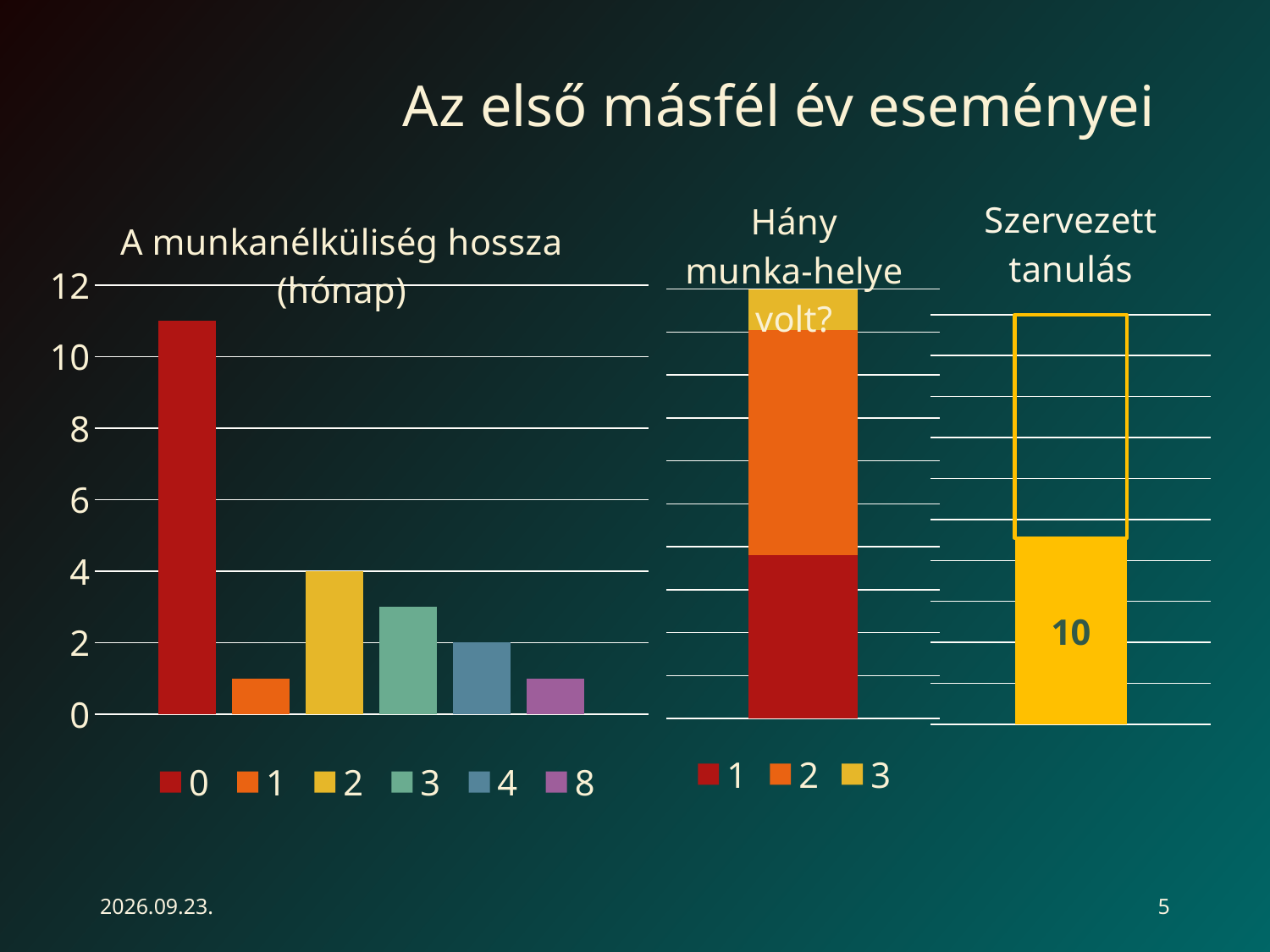
In the chart titled "A munkanélküliség hossza (hónap)", is the value for category 3 greater or less than 4? less In the chart titled "A munkanélküliség hossza (hónap)", is the value for category 0 greater or less than 10? greater What is the highest value shown on the vertical axis of the chart titled "A munkanélküliség hossza (hónap)"? 12 In the chart titled "A munkanélküliség hossza (hónap)", which is larger, the value for category 2 or the value for category 4? 2 In the chart titled "Szervezett tanulás", what value is printed on the bar? 10 In the chart titled "A munkanélküliség hossza (hónap)", what is the value for category 2? 4 In the chart titled "Hány munka-helye volt?", how many series does the legend list? 3 In the chart titled "Hány munka-helye volt?", which series occupies the largest segment of the stacked bar? 2 In the chart titled "A munkanélküliség hossza (hónap)", how many entries does the legend list? 6 In the chart titled "A munkanélküliség hossza (hónap)", which category has the highest bar? 0 In the chart titled "A munkanélküliség hossza (hónap)", what is the value for category 4? 2 What kind of chart is the chart titled "A munkanélküliség hossza (hónap)"? bar chart